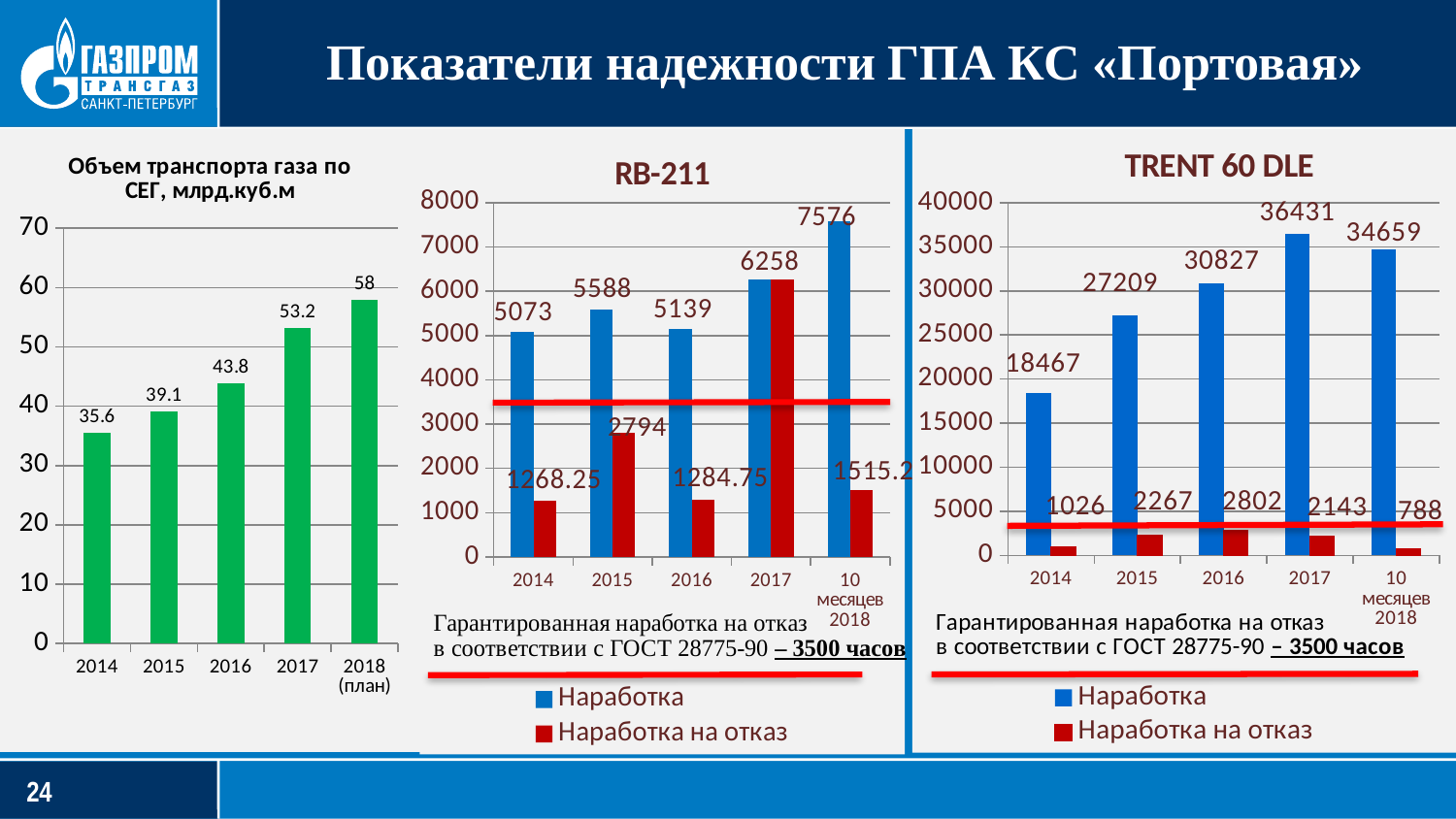
In the RB-211 chart, how many series does the legend list? 2 In the chart 'Объем транспорта газа по СЕГ, млрд.куб.м', which year has the lowest value? 2014 In the RB-211 chart, what is the 'Наработка на отказ' value for 2015? 2794 In the TRENT 60 DLE chart, which period has the lowest 'Наработка на отказ' value? 10 месяцев 2018 In the TRENT 60 DLE chart, what is the 'Наработка' value for 2015? 27209 In the chart 'Объем транспорта газа по СЕГ, млрд.куб.м', what is the value for 2016? 43.8 In the chart 'Объем транспорта газа по СЕГ, млрд.куб.м', what is the difference between the 2018 (план) value and the 2017 value? 4.8 In the chart 'Объем транспорта газа по СЕГ, млрд.куб.м', do the values rise or fall from 2014 to 2018 (план)? rise What type of chart is the TRENT 60 DLE chart? bar chart In the TRENT 60 DLE chart, which is larger, the 'Наработка' value for 2017 or for 10 месяцев 2018? 2017 In the RB-211 chart, which period has the highest 'Наработка' value? 10 месяцев 2018 In the RB-211 chart, what is the 'Наработка' value for 2017? 6258